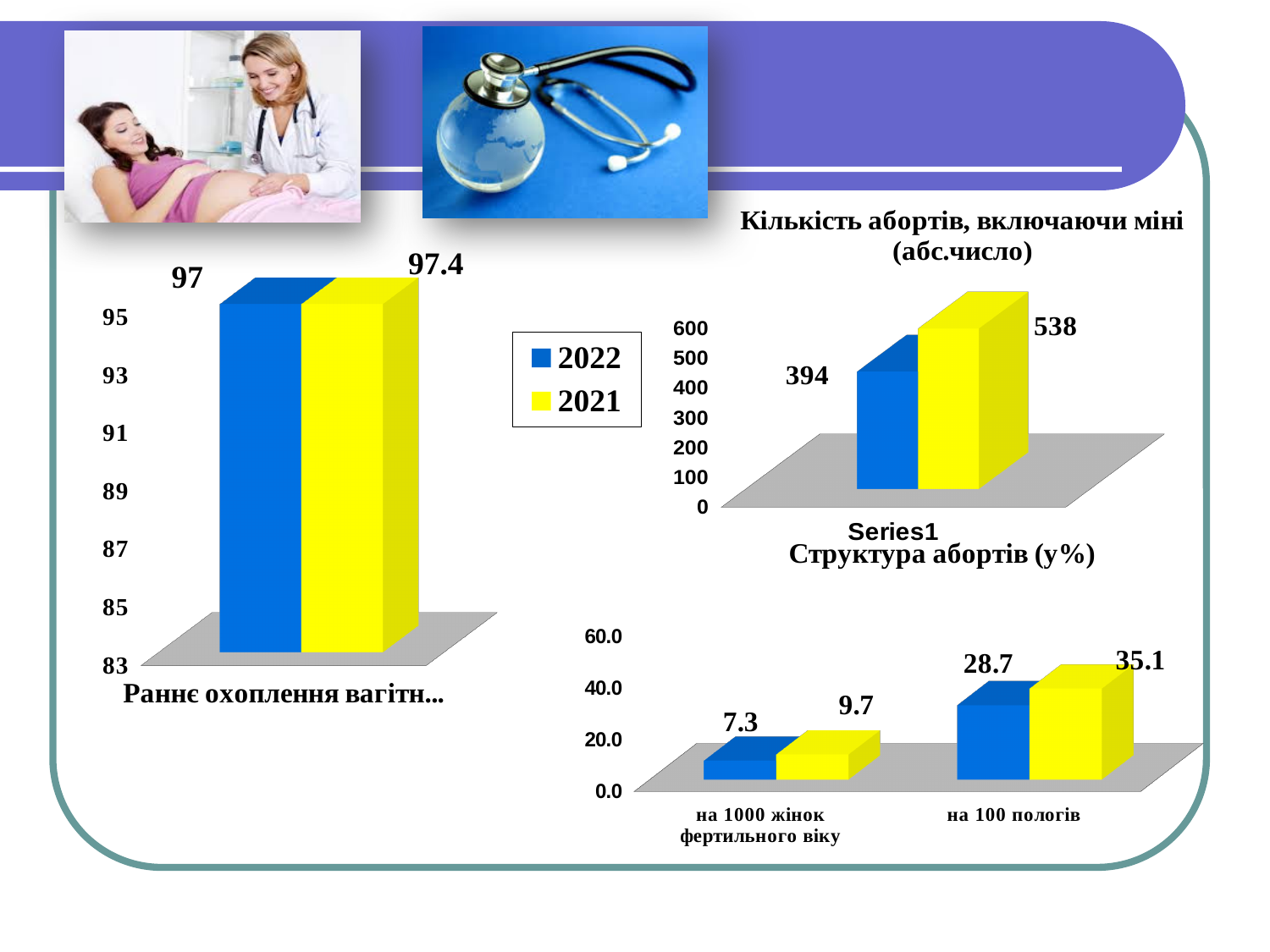
How many series does the legend on the slide list? 2 In the chart titled "Кількість абортів, включаючи міні (абс.число)", which year has the larger value, 2022 or 2021? 2021 In the chart titled "Кількість абортів, включаючи міні (абс.число)", what is the value of the yellow (2021) bar? 538 In the chart titled "Структура абортів (у%)", is the 2021 value for "на 100 пологів" greater or less than 40.0? less In the chart titled "Структура абортів (у%)", how many categories are shown on the x axis? 2 In the chart titled "Кількість абортів, включаючи міні (абс.число)", what is the value of the blue (2022) bar? 394 In the chart titled "Структура абортів (у%)", what is the 2021 value for "на 100 пологів"? 35.1 In the chart titled "Кількість абортів, включаючи міні (абс.число)", what is the difference between the 2021 and 2022 values? 144 In the chart titled "Структура абортів (у%)", what is the 2022 value for "на 1000 жінок фертильного віку"? 7.3 In the left chart ("Раннє охоплення вагітн..."), what is the value of the blue (2022) bar? 97 In the chart titled "Структура абортів (у%)", what is the difference between the 2021 and 2022 values for "на 100 пологів"? 6.4 In the left chart ("Раннє охоплення вагітн..."), what is the value of the yellow (2021) bar? 97.4